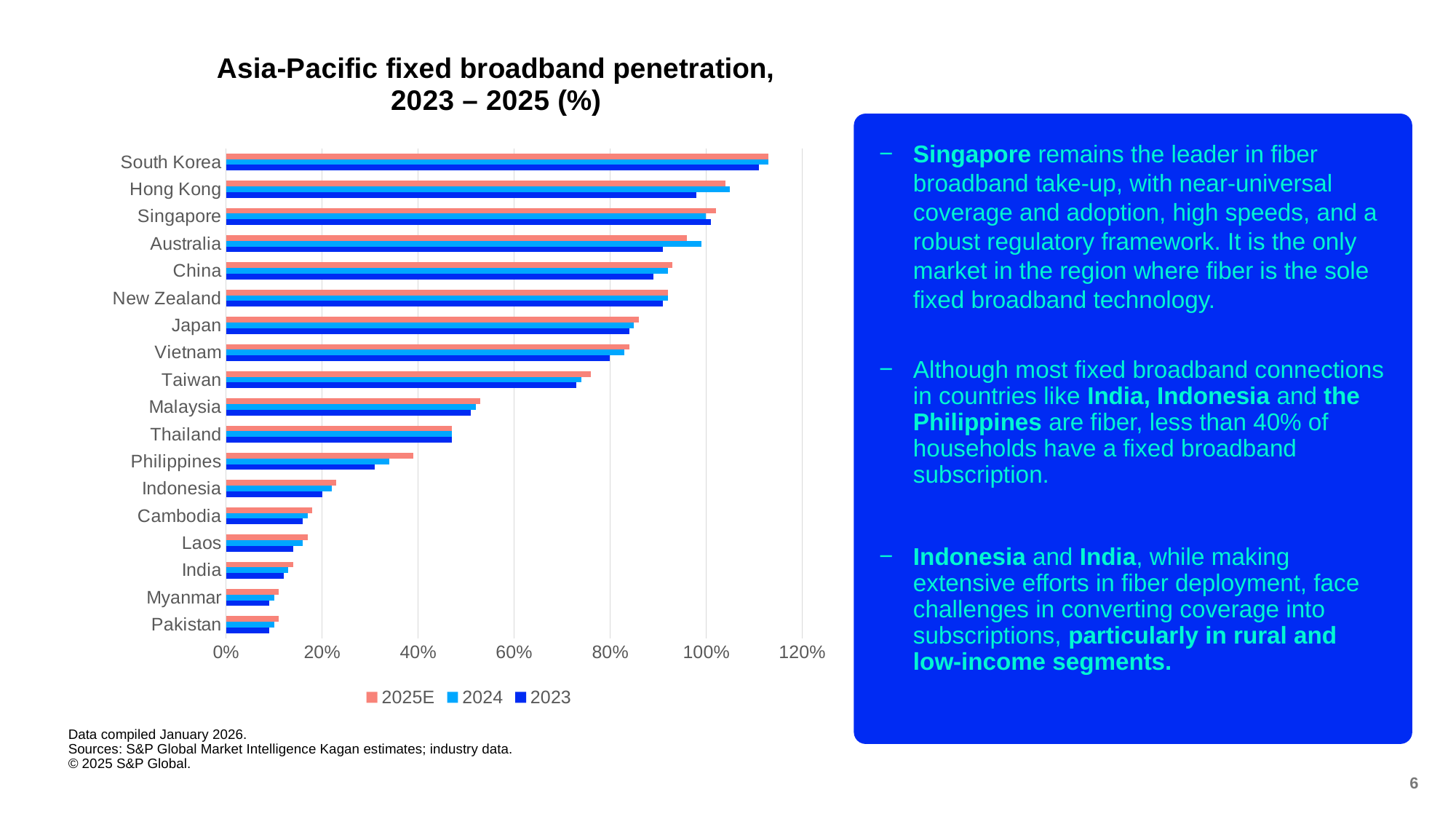
What is the title of the chart? Asia-Pacific fixed broadband penetration, 2023 – 2025 (%) Does the Philippines' penetration increase or decrease from 2023 to 2025E? increase Is the 2023 value for Malaysia greater or less than 40%? greater Which has the larger 2025E value, Malaysia or Thailand? Malaysia Which has the larger 2025E value, Taiwan or Vietnam? Vietnam Is the 2025E value for Taiwan greater or less than 80%? less Is the 2025E value for Thailand greater or less than 60%? less How many countries are listed on the chart? 18 How many series does the legend list? 3 Which country has the highest 2025E fixed broadband penetration? South Korea What type of chart is shown on the slide? Bar chart